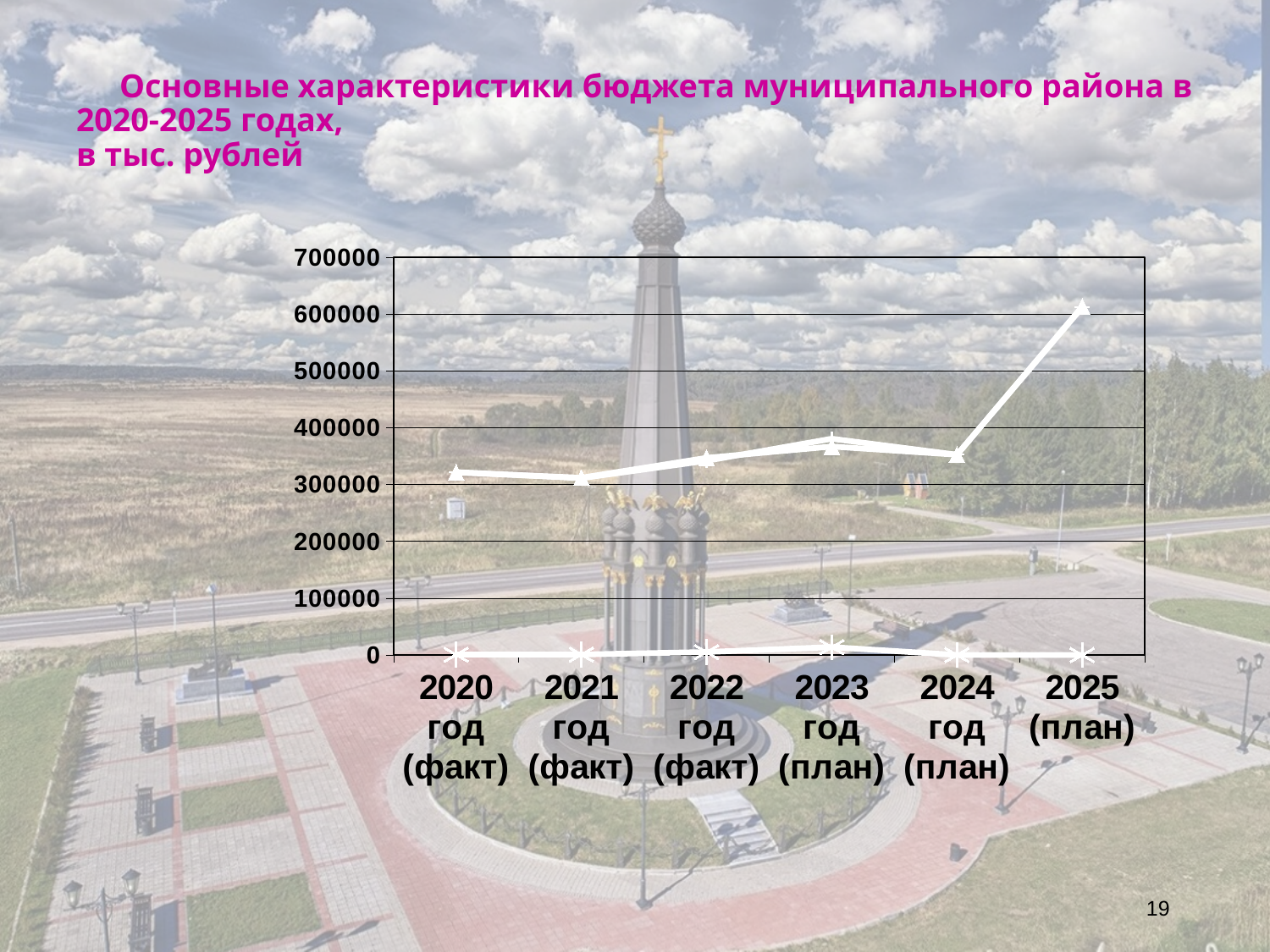
How many lines are plotted on the chart? 3 For the line with triangle markers, does the value rise or fall from 2024 год (план) to 2025 (план)? rise Is the value of the line with triangle markers for 2023 год (план) greater or less than 300000? greater Is the value of the line with star markers for 2022 год (факт) greater or less than 100000? less How many categories (years) are shown on the x axis of the chart? 6 Is the value of the line with triangle markers for 2025 (план) greater or less than 500000? greater For the line with triangle markers, which category has the highest value? 2025 (план) In what units are the values on the chart expressed, according to the slide title? тыс. рублей For the line with triangle markers, which is larger: the value for 2024 год (план) or 2025 (план)? 2025 (план) What kind of chart is shown on the slide? line chart